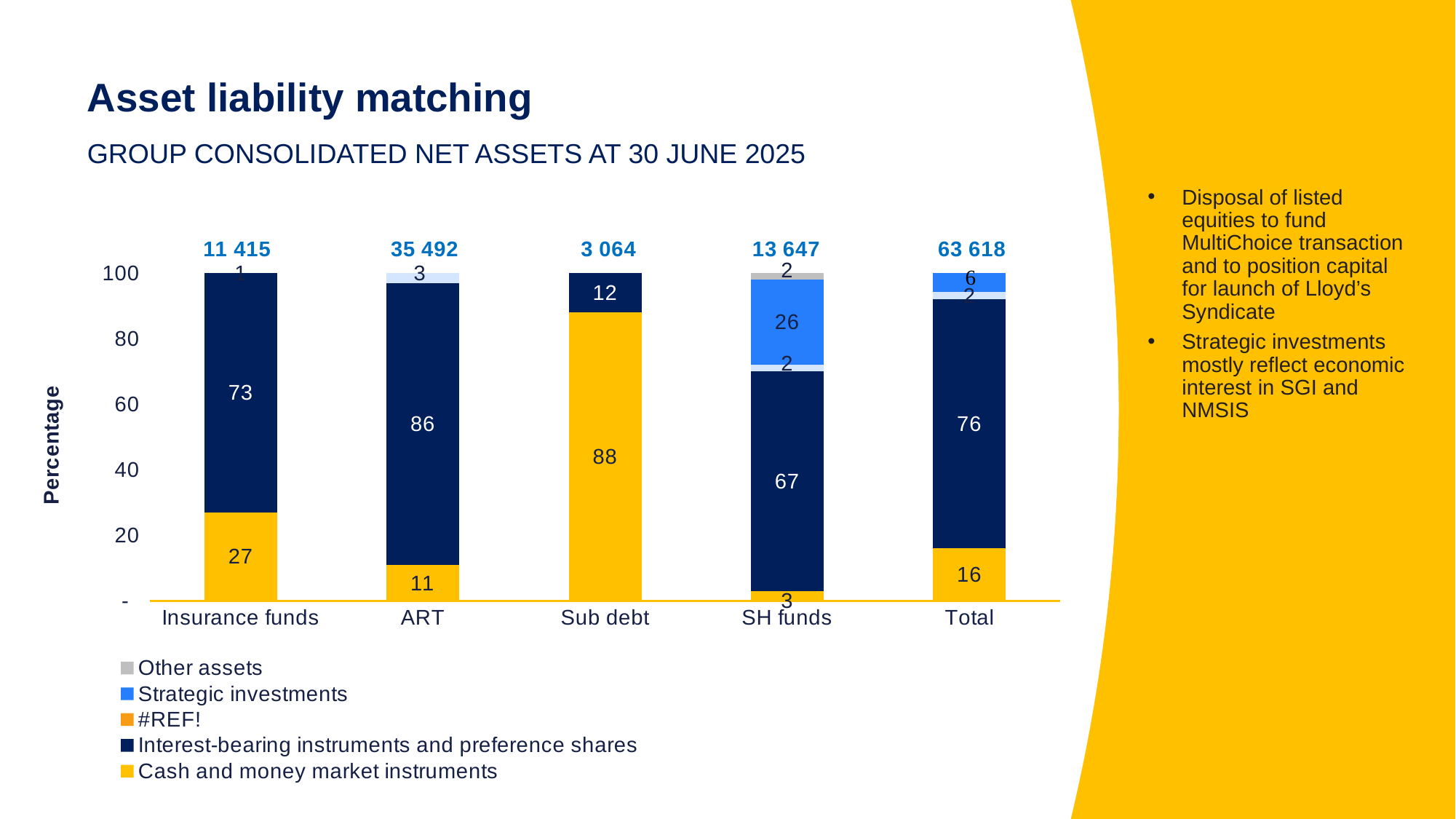
What is the Strategic investments percentage for SH funds? 26 Which is larger: the Cash and money market instruments percentage for Insurance funds or for ART? Insurance funds Which category has the lowest Cash and money market instruments percentage? SH funds What is the Cash and money market instruments percentage for Sub debt? 88 What is the Interest-bearing instruments and preference shares percentage for ART? 86 Which category has the highest Cash and money market instruments percentage? Sub debt What kind of chart is shown on the slide? stacked bar chart How many series does the chart legend list? 5 How many categories are shown on the x axis of the chart? 5 What is the Cash and money market instruments percentage for Total? 16 What is the difference between the Interest-bearing instruments and preference shares percentage for ART and for Insurance funds? 13 What figure is printed above the ART bar? 35 492